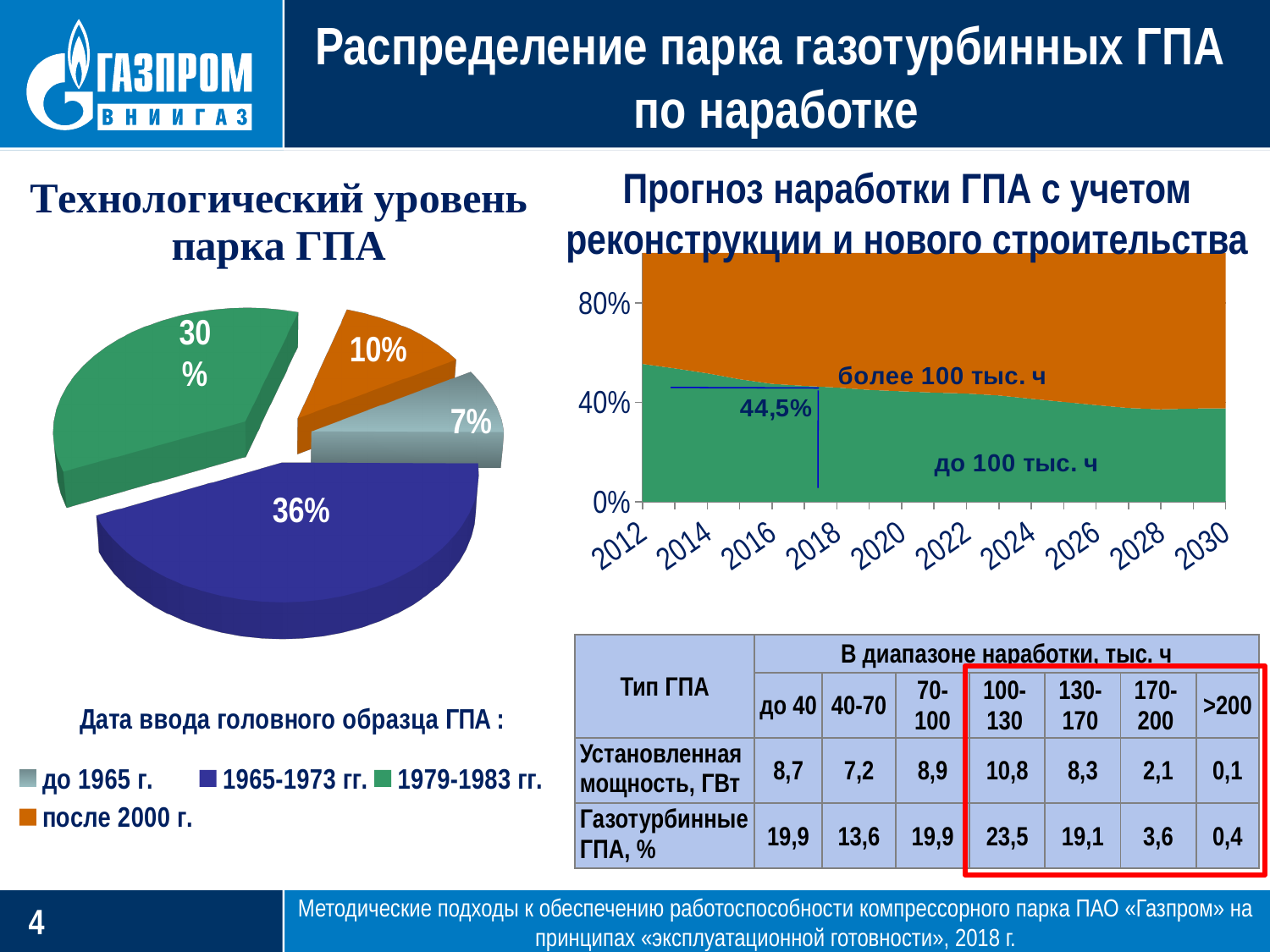
In the chart "Прогноз наработки ГПА с учетом реконструкции и нового строительства", does the share of the "до 100 тыс. ч" area rise or fall from 2012 to 2030? Fall In the pie chart "Технологический уровень парка ГПА", what share is shown for the slice labelled "после 2000 г."? 10% In the chart "Прогноз наработки ГПА с учетом реконструкции и нового строительства", which series is shown in orange? более 100 тыс. ч In the pie chart "Технологический уровень парка ГПА", what share is shown for the slice labelled "1965-1973 гг."? 36% In the pie chart "Технологический уровень парка ГПА", how many categories does the legend list? 4 In the pie chart "Технологический уровень парка ГПА", which category has the smallest slice? до 1965 г. What kind of chart is "Технологический уровень парка ГПА"? Pie chart In the chart "Прогноз наработки ГПА с учетом реконструкции и нового строительства", what value is labelled for 2018? 44,5% In the pie chart "Технологический уровень парка ГПА", what share is shown for the slice labelled "1979-1983 гг."? 30% In the pie chart "Технологический уровень парка ГПА", what share is shown for the slice labelled "до 1965 г."? 7% In the pie chart "Технологический уровень парка ГПА", what is the difference in percentage points between the "1965-1973 гг." slice and the "1979-1983 гг." slice? 6 In the pie chart "Технологический уровень парка ГПА", which category has the largest slice? 1965-1973 гг.